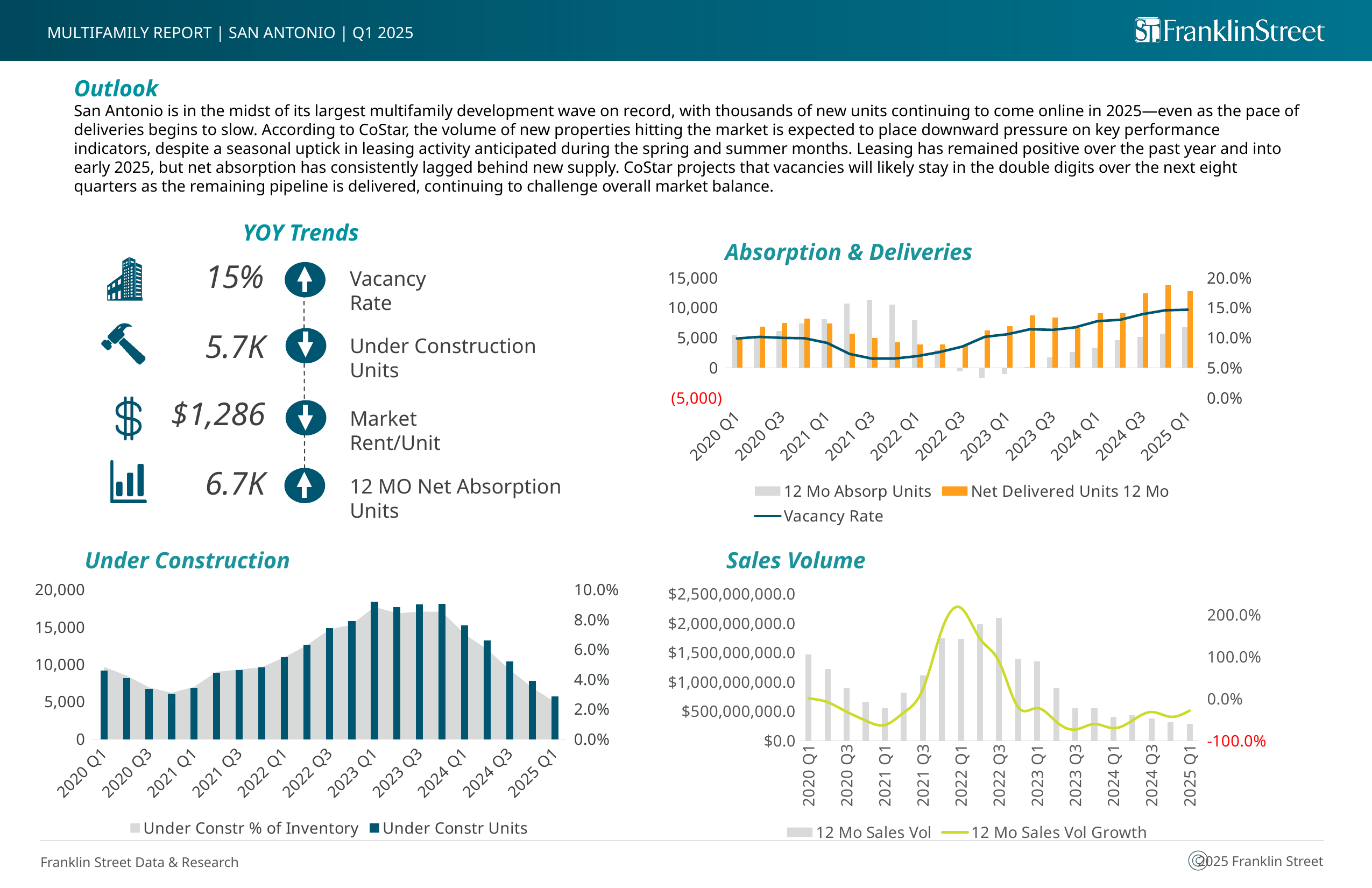
In the Under Construction chart, is the Under Constr Units value for 2023 Q1 greater or less than 15,000? greater In the Absorption & Deliveries chart, is the Vacancy Rate for 2021 Q3 greater or less than 10.0%? less In the Under Construction chart, do the Under Constr Units values rise or fall from 2023 Q1 to 2025 Q1? fall In the Absorption & Deliveries chart, does the Vacancy Rate line generally rise or fall from 2022 Q1 to 2025 Q1? rise In the Absorption & Deliveries chart, which colour represents Net Delivered Units 12 Mo? Orange How many series does the legend of the Absorption & Deliveries chart list? 3 In the Under Construction chart, is the Under Constr Units value for 2025 Q1 greater or less than 10,000? less In the Sales Volume chart, which is larger, the 12 Mo Sales Vol for 2020 Q1 or for 2025 Q1? 2020 Q1 How many series does the legend of the Under Construction chart list? 2